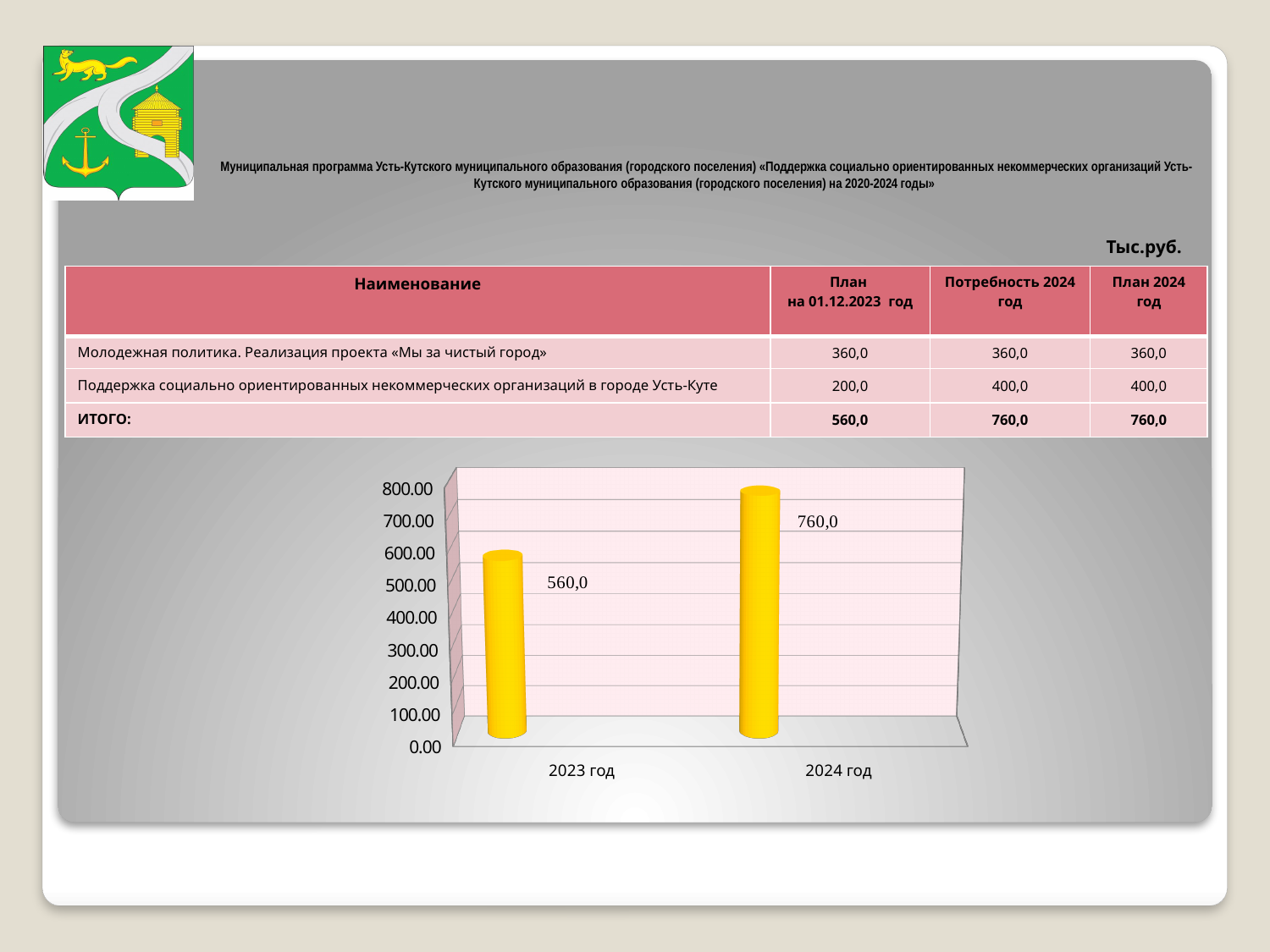
Which is larger, the value for 2023 год or 2024 год? 2024 год What is the difference between the values for 2024 год and 2023 год? 200,0 What kind of chart is shown on the slide? bar chart Which category has the lowest value in the chart? 2023 год What colour are the bars in the chart? yellow Is the value for 2023 год greater or less than 600.00? less What is the value for 2023 год in the chart? 560,0 Is the value for 2024 год greater or less than 700.00? greater Do the values rise or fall from 2023 год to 2024 год? rise How many categories are shown on the x axis of the chart? 2 What is the value for 2024 год in the chart? 760,0 Which category has the highest value in the chart? 2024 год